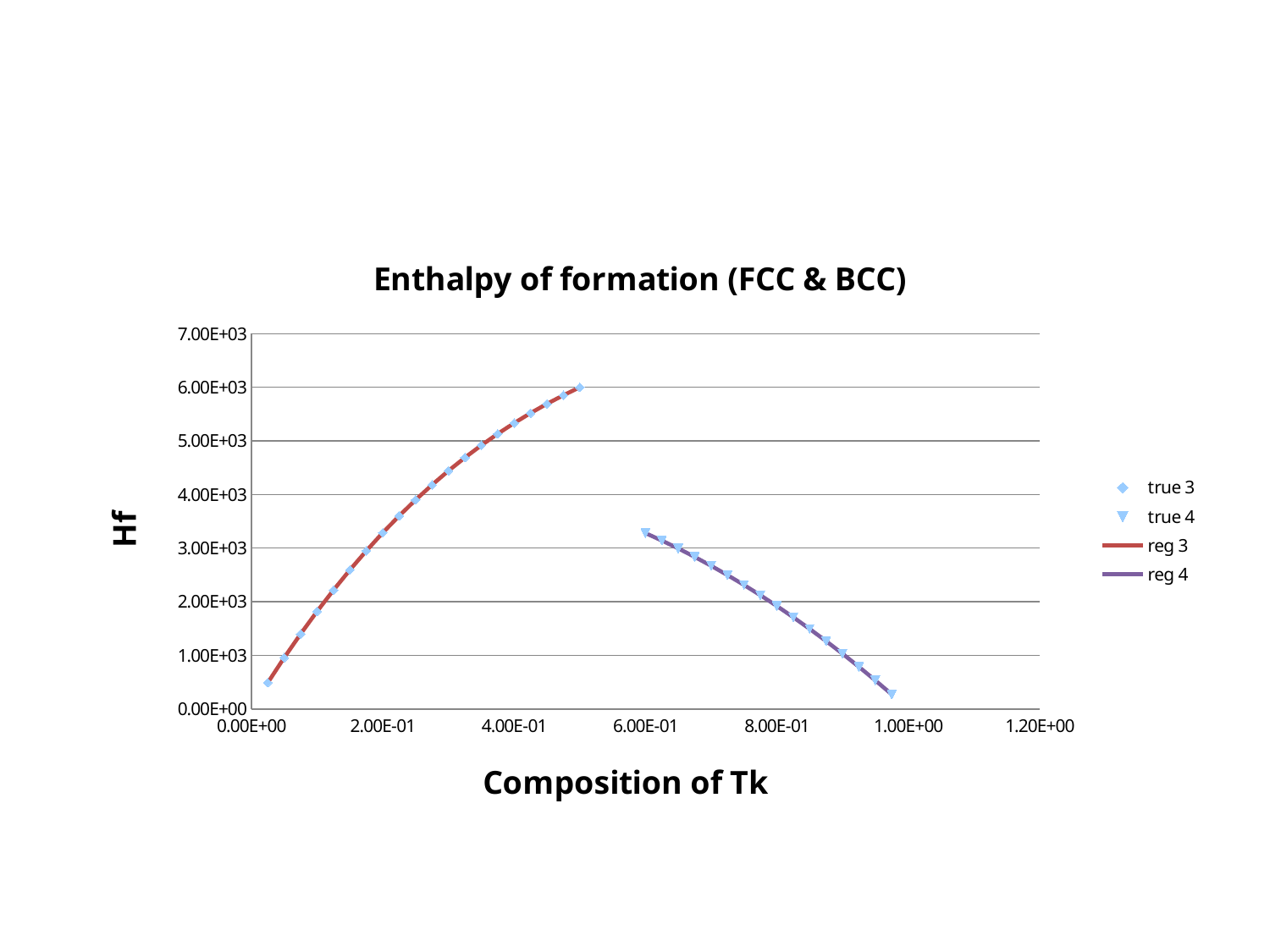
How many series does the legend list? 4 Is the Hf value of the 'true 4' series at its right-most point (near Composition of Tk 1.00E+00) greater or less than 1.00E+03? less Do the values of the 'true 3' series rise or fall as Composition of Tk increases? rise Which series reaches the highest Hf value on the chart, 'true 3' or 'true 4'? true 3 Is the Hf value of the 'true 3' series at Composition of Tk 4.00E-01 greater or less than 4.00E+03? greater What is the label of the x axis? Composition of Tk Which series contains the lowest Hf value on the chart, 'true 3' or 'true 4'? true 4 Is the Hf value of the 'true 4' series at Composition of Tk 8.00E-01 greater or less than 3.00E+03? less Which is larger: the Hf value of 'true 3' at Composition of Tk 4.00E-01 or the Hf value of 'true 4' at Composition of Tk 8.00E-01? true 3 at 4.00E-01 What is the title of the chart? Enthalpy of formation (FCC & BCC) What kind of chart is shown on the slide? scatter chart Do the values of the 'true 4' series rise or fall as Composition of Tk increases? fall